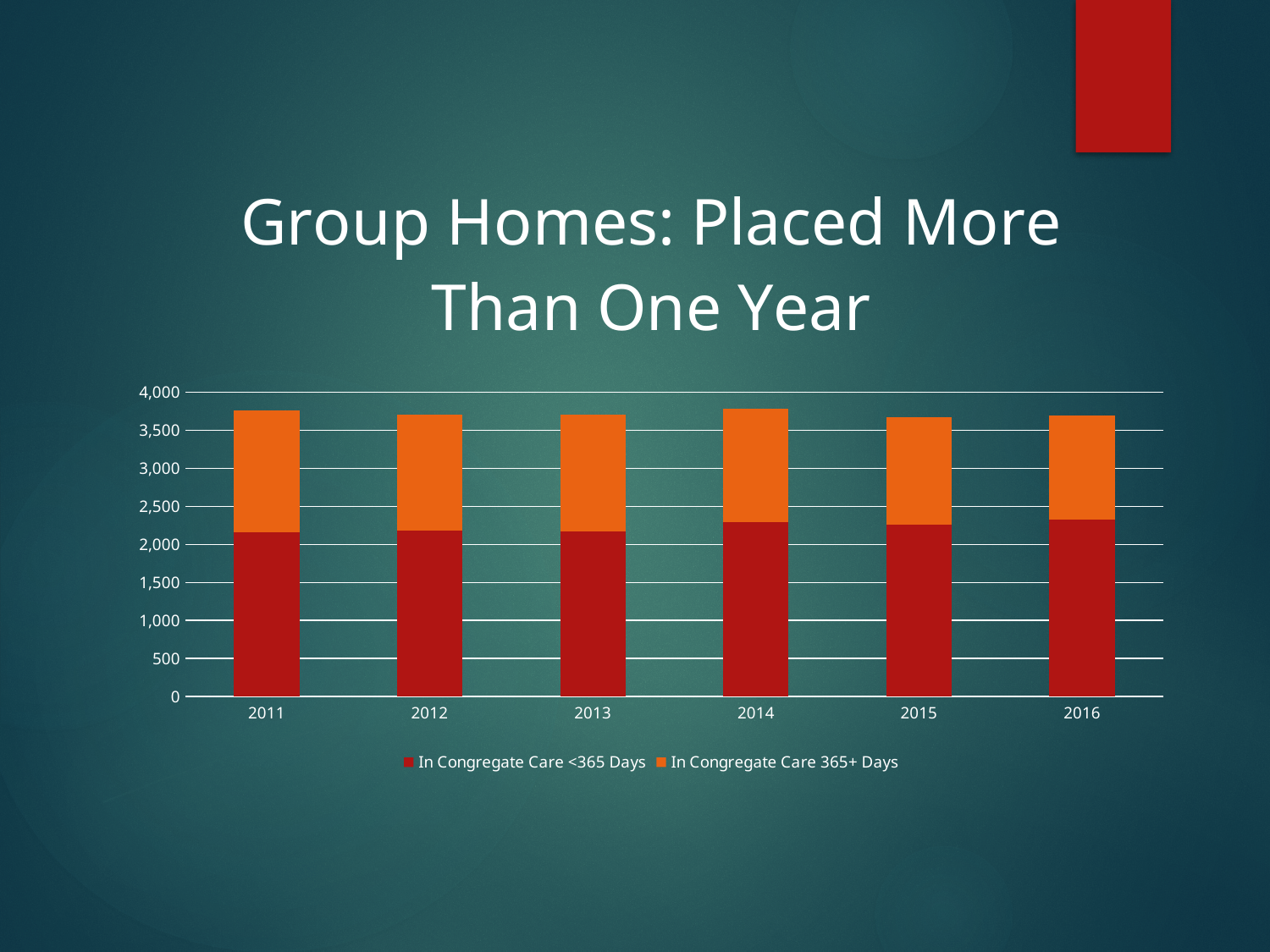
Is the total height of the stacked bar for 2014 greater or less than 4,000? less What kind of chart is shown on the slide? Stacked bar chart Which series is shown in orange in the chart? In Congregate Care 365+ Days Is the value for In Congregate Care <365 Days in 2011 greater or less than 2,000? greater What is the title of the chart on the slide? Group Homes: Placed More Than One Year What is the first year shown on the x axis of the chart? 2011 Is the value for In Congregate Care <365 Days in 2013 greater or less than 1,500? greater How many series does the chart's legend list? 2 How many years are shown on the x axis of the chart? 6